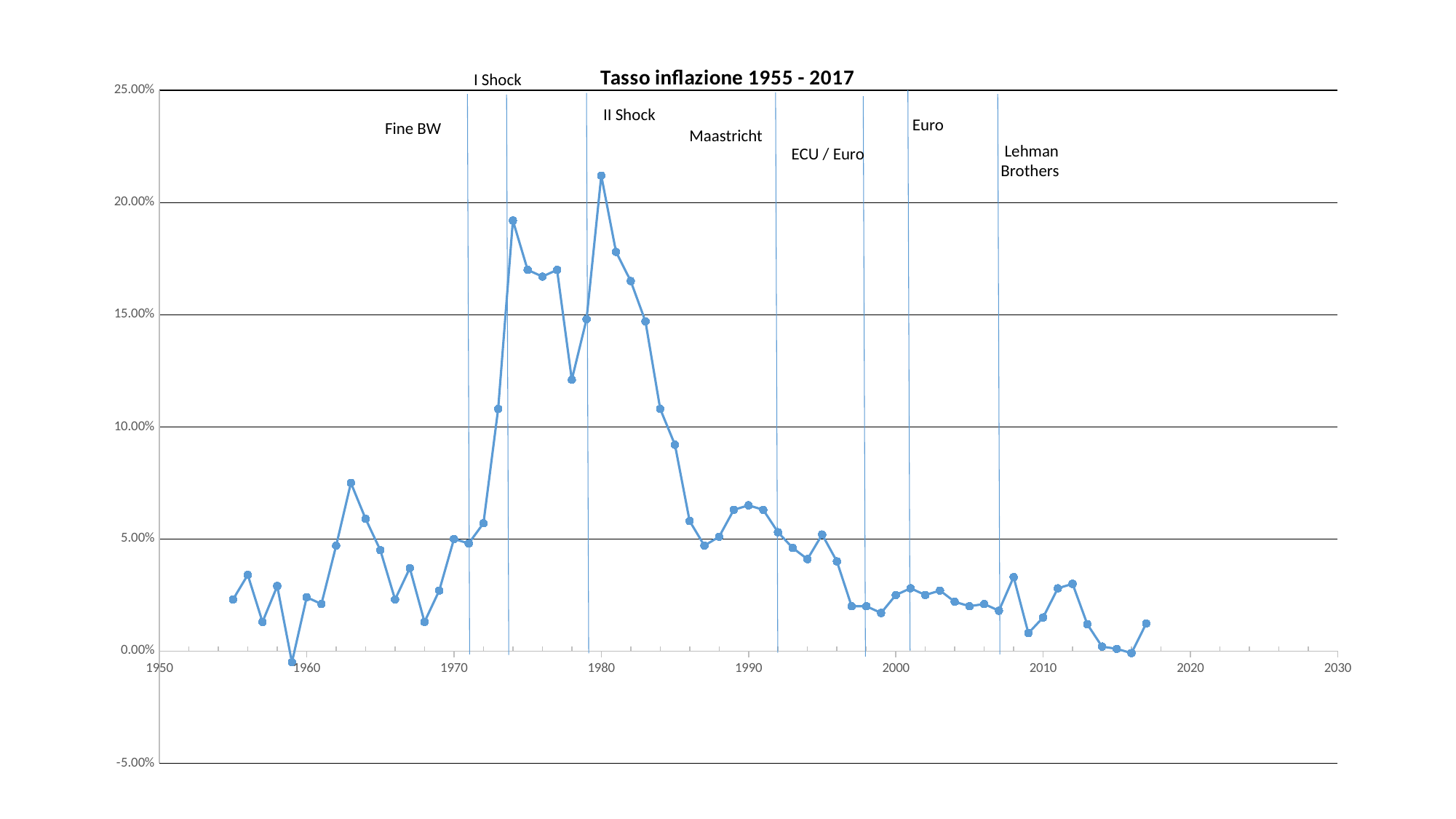
Is the value for 1980 greater or less than 20.00%? greater Which year has the lowest inflation rate on the chart? 1959 Is the value for 1990 greater or less than 10.00%? less Is the value for 1974 greater or less than 15.00%? greater What is the title of the chart? Tasso inflazione 1955 - 2017 Which year has the highest inflation rate on the chart? 1980 Which year has the larger inflation rate, 1974 or 1980? 1980 What kind of chart is shown on the slide? line chart Do the values rise or fall between 1980 and 1987? fall Which event label is placed at the vertical line near 2007? Lehman Brothers